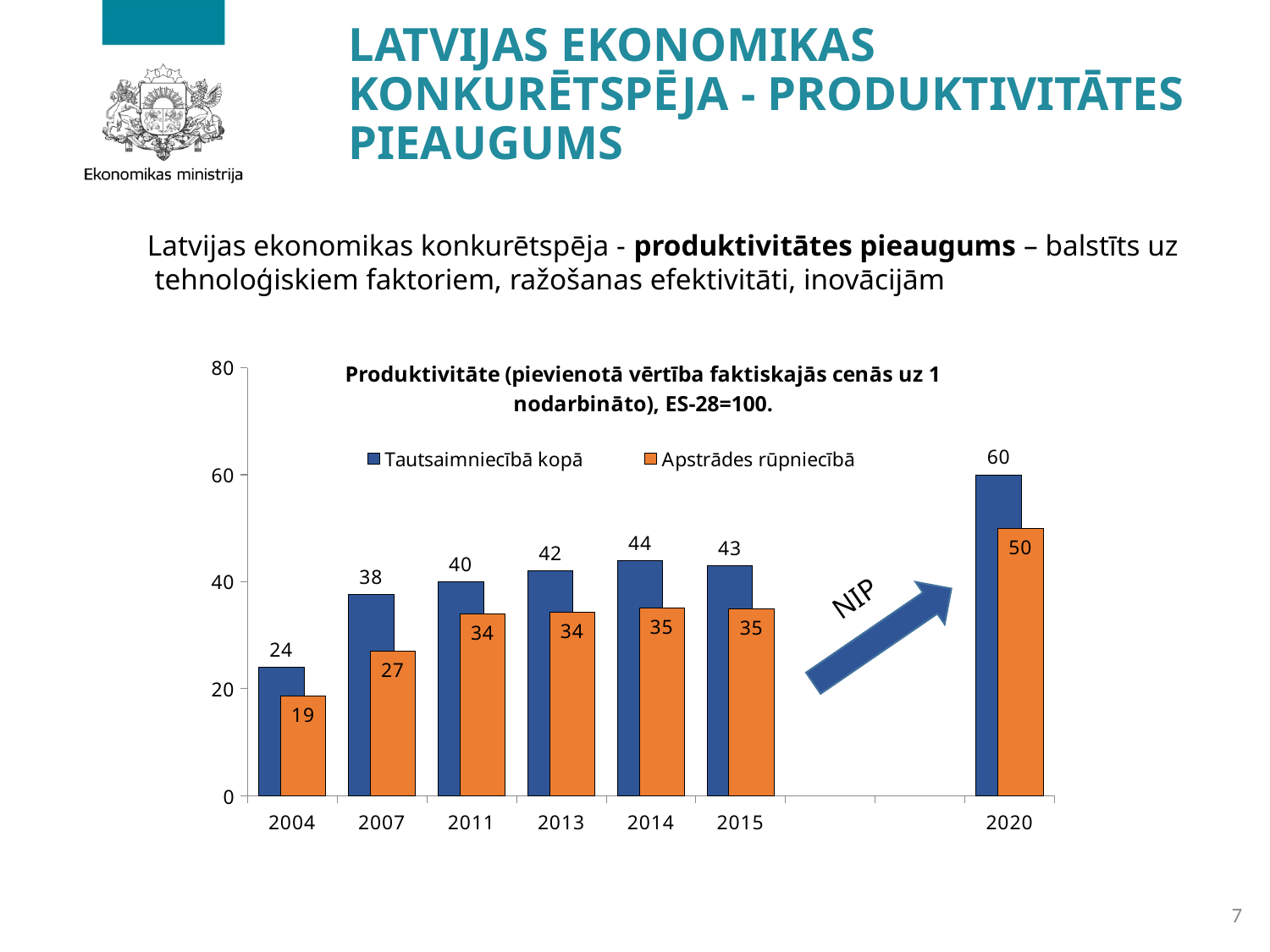
How many years are shown on the x axis of the chart? 7 What is the difference between Tautsaimniecībā kopā and Apstrādes rūpniecībā in 2015? 8 What type of chart is shown on the slide? bar chart In which year is the value for Tautsaimniecībā kopā highest? 2020 What is the value for Apstrādes rūpniecībā in 2007? 27 In which year is the value for Apstrādes rūpniecībā lowest? 2004 Which colour represents Apstrādes rūpniecībā in the chart? orange What is the value for Apstrādes rūpniecībā in 2020? 50 Which is larger in 2014: Tautsaimniecībā kopā or Apstrādes rūpniecībā? Tautsaimniecībā kopā How many series does the legend list? 2 Does the value for Tautsaimniecībā kopā rise or fall from 2004 to 2014? rise What is the value for Tautsaimniecībā kopā in 2004? 24